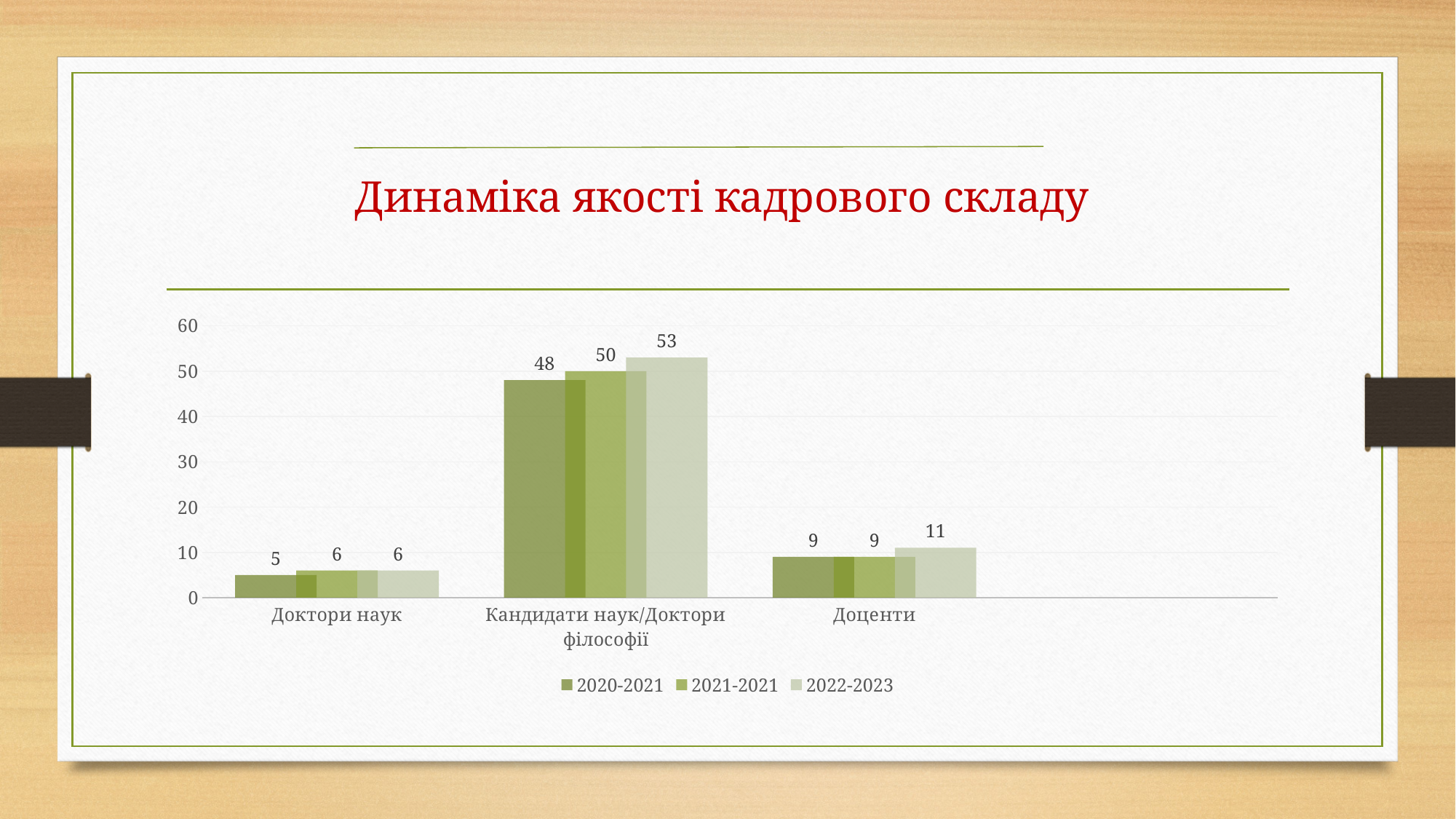
What is the value for Кандидати наук/Доктори філософії in the 2022-2023 series? 53 Which category has the lowest value in the 2020-2021 series? Доктори наук How many series does the legend list? 3 How many categories are shown on the x axis? 3 Do the values for Кандидати наук/Доктори філософії rise or fall from 2020-2021 to 2022-2023? Rise What is the difference between the 2022-2023 and 2020-2021 values for Кандидати наук/Доктори філософії? 5 What kind of chart is shown on the slide? Bar chart What is the title of the chart on the slide? Динаміка якості кадрового складу Which is larger for Доценти: the 2020-2021 value or the 2022-2023 value? 2022-2023 What is the value for Доктори наук in the 2020-2021 series? 5 Which category has the highest value in the 2021-2021 series? Кандидати наук/Доктори філософії What is the value for Доценти in the 2022-2023 series? 11